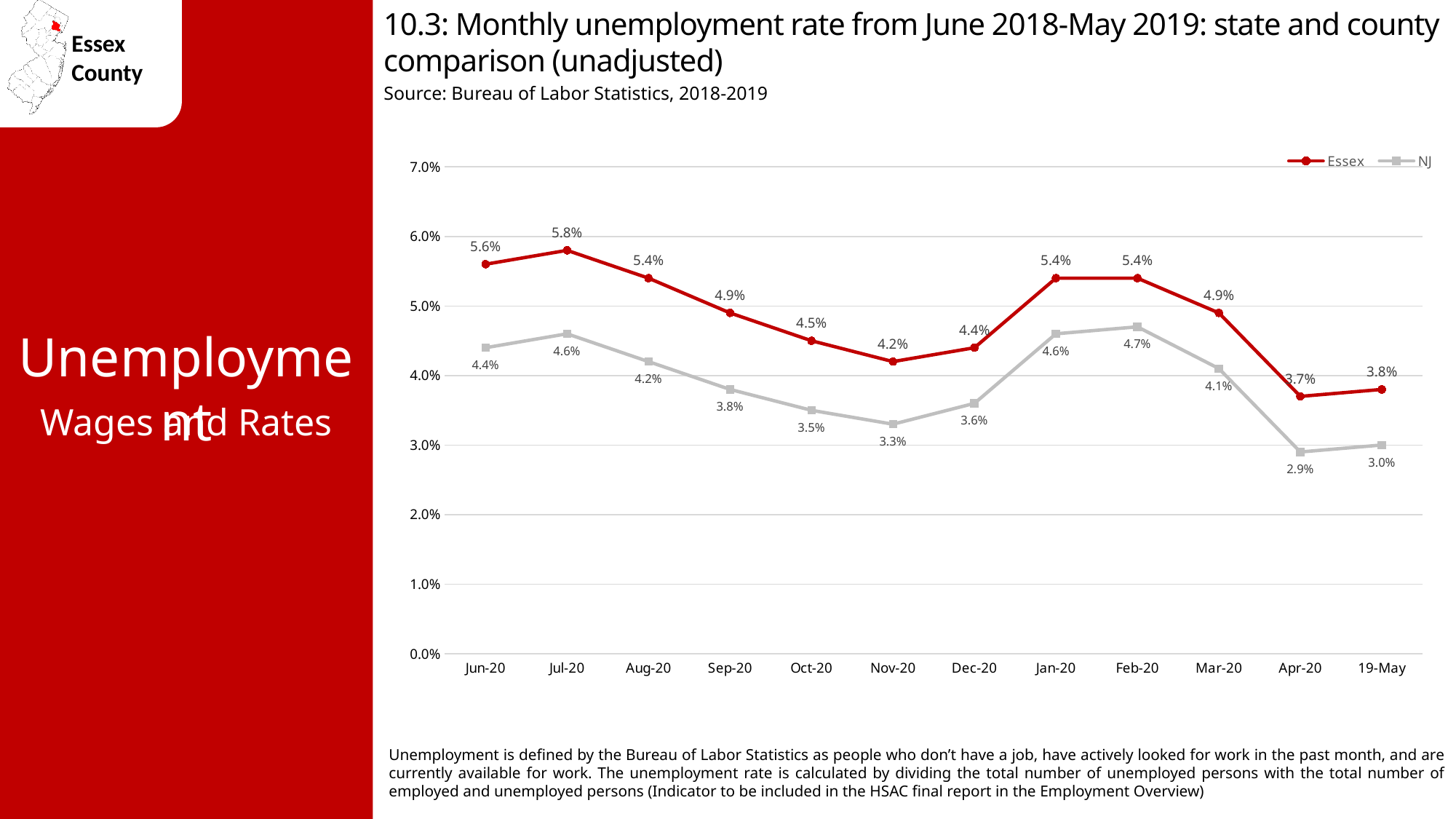
In which month does the Essex series reach its highest value? Jul-20 What is the NJ unemployment rate for Nov-20? 3.3% What is the Essex unemployment rate for Jul-20? 5.8% In which month does the NJ series reach its lowest value? Apr-20 What kind of chart is shown on the slide? Line chart What is the difference between the Essex and NJ rates in Jun-20? 1.2% How many series does the legend list? 2 What colour is the Essex line in the chart? Red Which series has the higher value in Feb-20, Essex or NJ? Essex How many months are plotted on the x axis? 12 What is the Essex unemployment rate for Apr-20? 3.7% Does the Essex rate rise or fall from Jul-20 to Nov-20? Fall